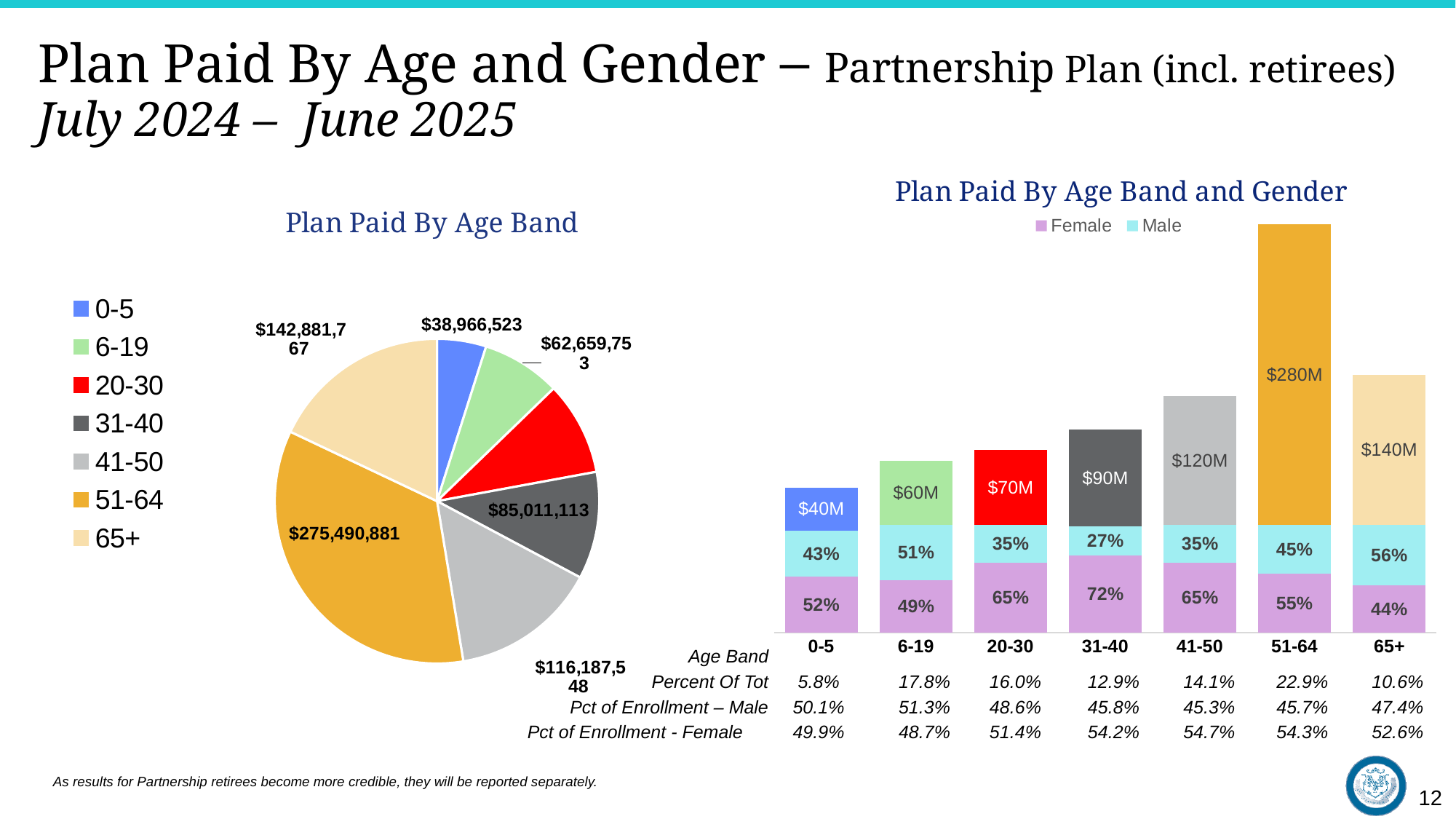
In the Plan Paid By Age Band pie chart, what is the difference between the 65+ value and the 41-50 value? $26,694,219 What kind of chart is the Plan Paid By Age Band and Gender chart? Bar chart In the Plan Paid By Age Band and Gender chart, what is the plan paid amount for the 51-64 age band? $280M In the Plan Paid By Age Band pie chart, what is the value for the 51-64 age band? $275,490,881 In the Plan Paid By Age Band pie chart, which age band has the largest slice? 51-64 In the Plan Paid By Age Band pie chart, which age band has the smallest slice? 0-5 In the Plan Paid By Age Band and Gender chart, what is the Male percentage for the 65+ age band? 56% How many age bands are listed in the legend of the Plan Paid By Age Band pie chart? 7 In the Plan Paid By Age Band pie chart, what is the value for the 0-5 age band? $38,966,523 In the Plan Paid By Age Band and Gender chart, what is the Female percentage for the 31-40 age band? 72% In the Plan Paid By Age Band and Gender chart, what is the difference between the plan paid amounts for 51-64 and 65+? $140M How many series does the legend of the Plan Paid By Age Band and Gender chart list? 2